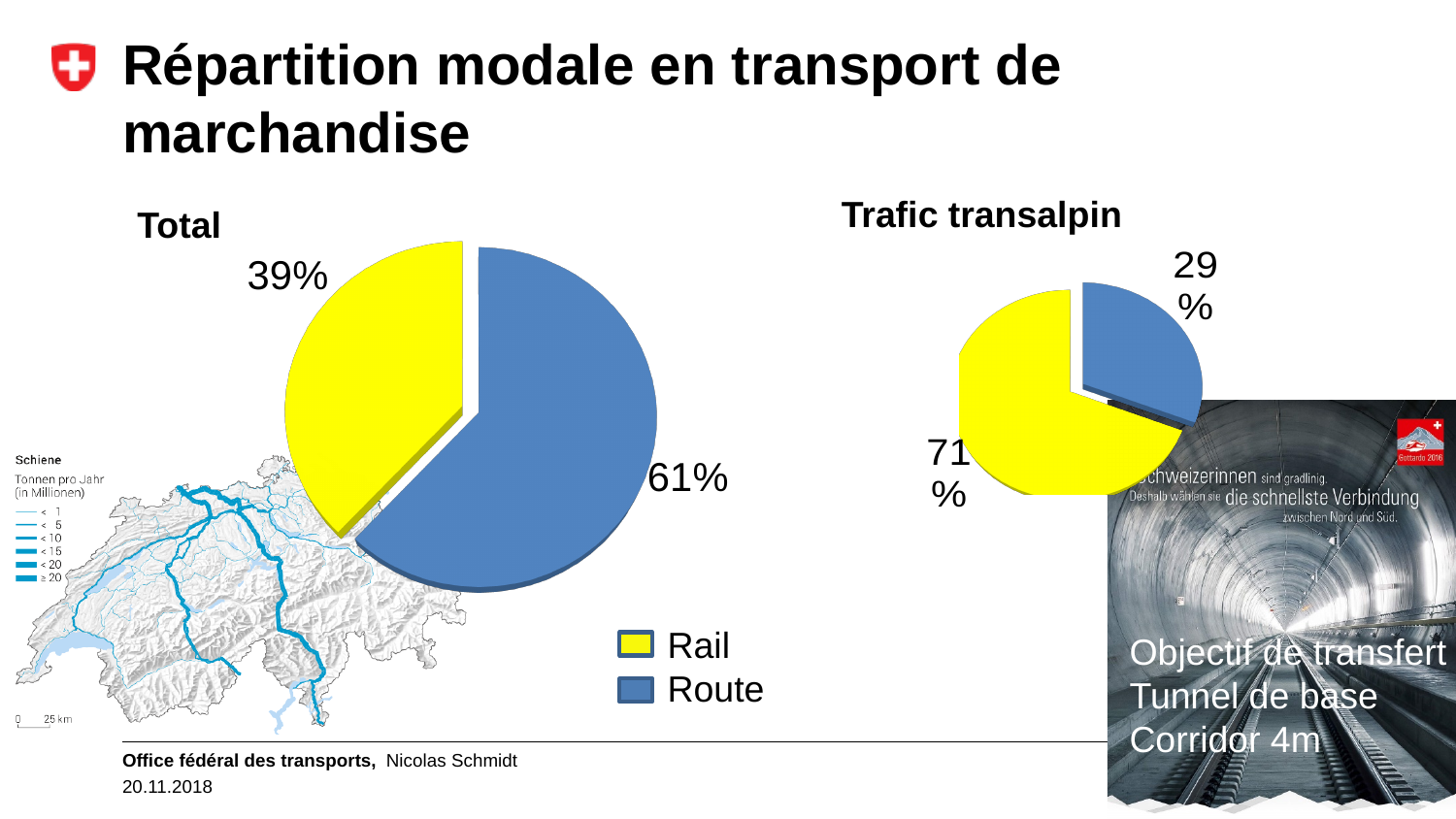
In the 'Total' pie chart, what share does Rail have? 39% How many slices does the 'Trafic transalpin' pie chart have? 2 In the 'Total' pie chart, what share does Route have? 61% Is the Rail share larger in the 'Total' chart or in the 'Trafic transalpin' chart? Trafic transalpin In the 'Total' pie chart, what is the difference between the Route share and the Rail share? 22% In the 'Trafic transalpin' pie chart, what is the difference between the Rail share and the Route share? 42% In the 'Trafic transalpin' pie chart, what share does Route have? 29% In the 'Trafic transalpin' pie chart, which mode has the smaller share? Route In the 'Trafic transalpin' pie chart, what share does Rail have? 71% What type of chart is used for 'Total' and 'Trafic transalpin'? Pie chart Which colour represents Rail in the legend? Yellow In the 'Total' pie chart, which mode has the larger share? Route